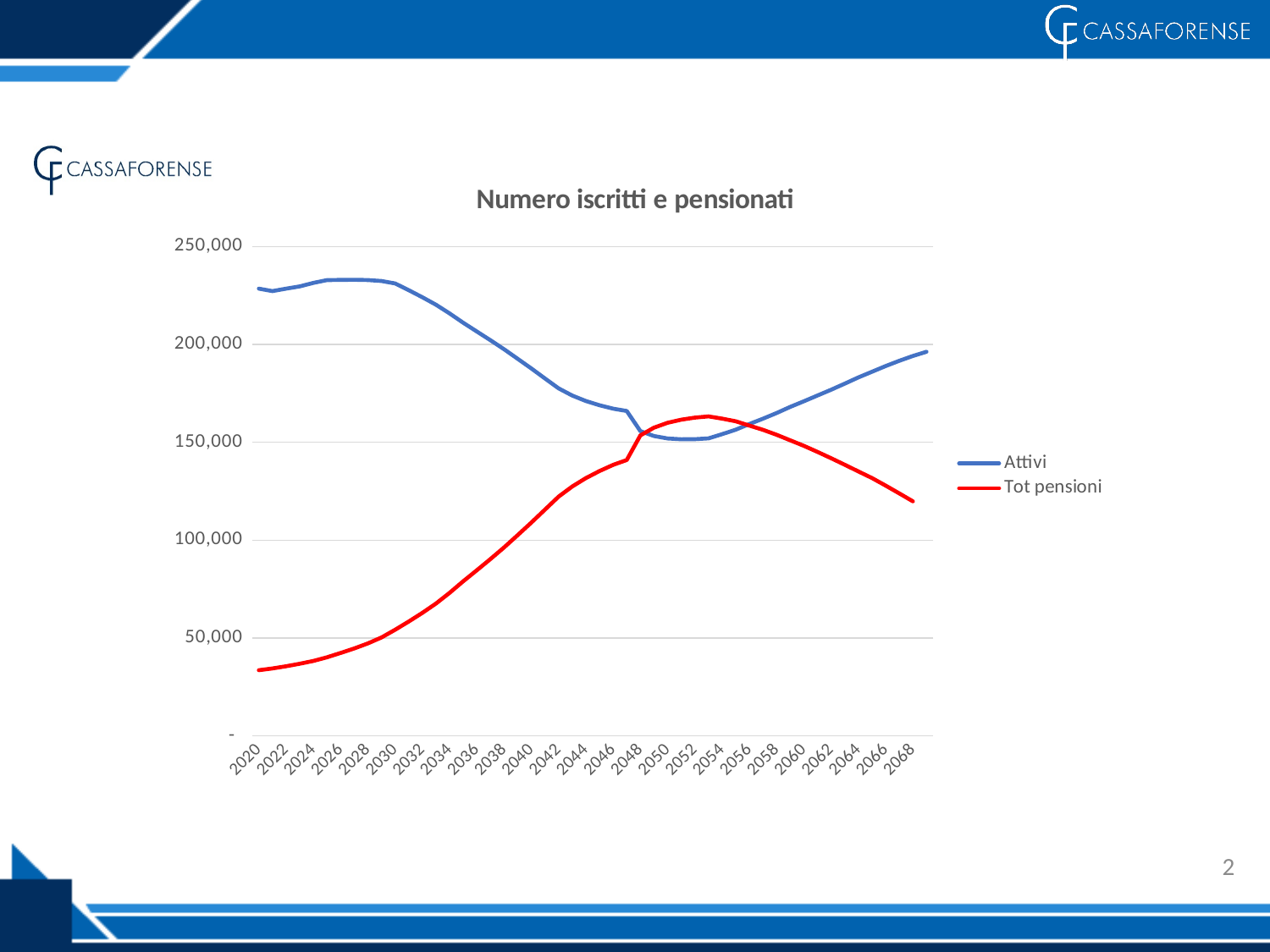
What kind of chart is shown on the slide? Line chart Is the value for Tot pensioni in 2020 greater or less than 50,000? less Is the value for Attivi in 2020 greater or less than 200,000? greater Does the Tot pensioni line rise or fall between 2020 and 2054? Rises How many series does the legend list? 2 How many year labels are shown on the x axis? 25 What colour is the Tot pensioni line? Red In 2068, which series has the larger value, Attivi or Tot pensioni? Attivi In 2020, which series has the larger value, Attivi or Tot pensioni? Attivi What is the title of the chart? Numero iscritti e pensionati Is the value for Tot pensioni in 2068 greater or less than 100,000? greater